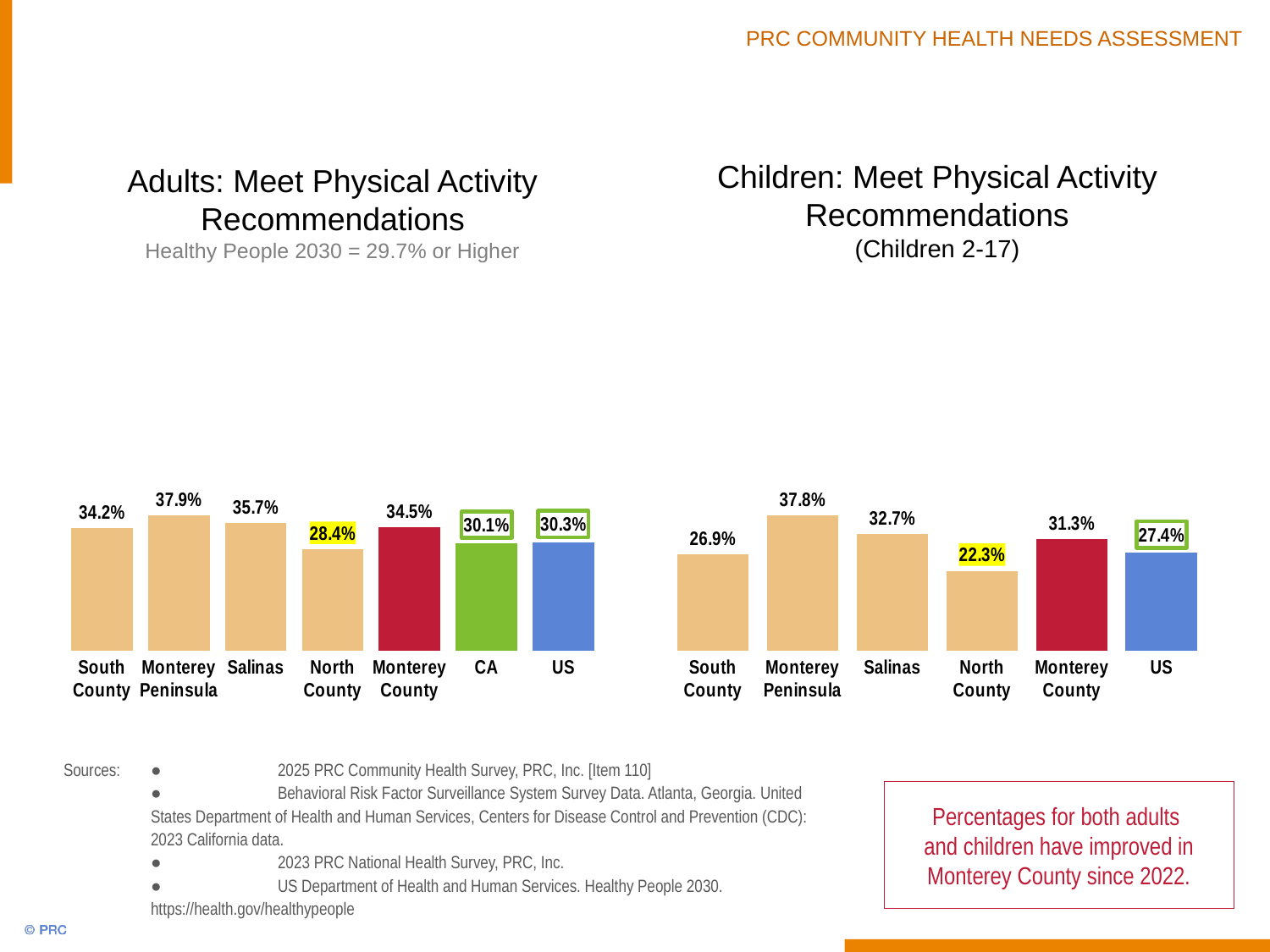
What Healthy People 2030 target is stated under the 'Adults: Meet Physical Activity Recommendations' chart title? 29.7% or Higher In the 'Children: Meet Physical Activity Recommendations' chart, which category has the lowest value? North County In the 'Adults: Meet Physical Activity Recommendations' chart, which category has the lowest value? North County In the 'Children: Meet Physical Activity Recommendations' chart, how many categories are shown? 6 In the 'Adults: Meet Physical Activity Recommendations' chart, how many categories are shown? 7 In the 'Children: Meet Physical Activity Recommendations' chart, which is larger, the value for Monterey County or the value for US? Monterey County In the 'Children: Meet Physical Activity Recommendations' chart, what is the value for Salinas? 32.7% In the 'Adults: Meet Physical Activity Recommendations' chart, which category has the highest value? Monterey Peninsula In the 'Children: Meet Physical Activity Recommendations' chart, what is the difference between the Monterey Peninsula and South County values? 10.9% What kind of chart is the 'Children: Meet Physical Activity Recommendations' chart? Bar chart In the 'Adults: Meet Physical Activity Recommendations' chart, what is the difference between the Monterey Peninsula and North County values? 9.5% In the 'Adults: Meet Physical Activity Recommendations' chart, what is the value for Monterey County? 34.5%